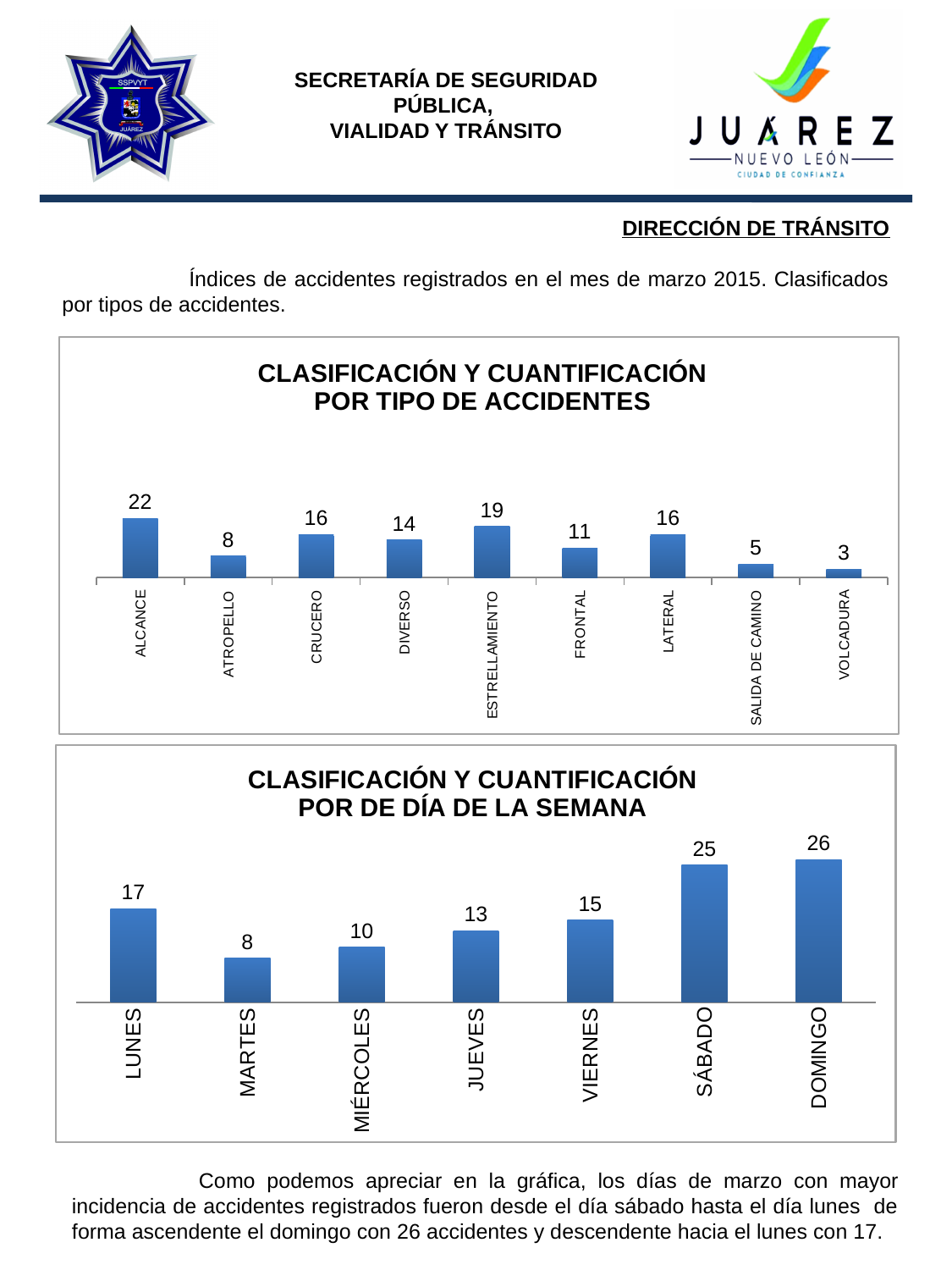
In the chart 'CLASIFICACIÓN Y CUANTIFICACIÓN POR DE DÍA DE LA SEMANA', what is the difference between DOMINGO and LUNES? 9 In the chart 'CLASIFICACIÓN Y CUANTIFICACIÓN POR DE DÍA DE LA SEMANA', which day has the lowest value? MARTES In the chart 'CLASIFICACIÓN Y CUANTIFICACIÓN POR TIPO DE ACCIDENTES', which category has the lowest value? VOLCADURA What kind of chart is 'CLASIFICACIÓN Y CUANTIFICACIÓN POR DE DÍA DE LA SEMANA'? bar chart In the chart 'CLASIFICACIÓN Y CUANTIFICACIÓN POR TIPO DE ACCIDENTES', how many categories are shown? 9 In the chart 'CLASIFICACIÓN Y CUANTIFICACIÓN POR TIPO DE ACCIDENTES', what is the value for ALCANCE? 22 In the chart 'CLASIFICACIÓN Y CUANTIFICACIÓN POR TIPO DE ACCIDENTES', what is the difference between ESTRELLAMIENTO and FRONTAL? 8 In the chart 'CLASIFICACIÓN Y CUANTIFICACIÓN POR DE DÍA DE LA SEMANA', which day has the highest value? DOMINGO In the chart 'CLASIFICACIÓN Y CUANTIFICACIÓN POR DE DÍA DE LA SEMANA', do the values rise or fall from MARTES to DOMINGO? rise In the chart 'CLASIFICACIÓN Y CUANTIFICACIÓN POR DE DÍA DE LA SEMANA', what is the value for SÁBADO? 25 In the chart 'CLASIFICACIÓN Y CUANTIFICACIÓN POR TIPO DE ACCIDENTES', which is larger, DIVERSO or SALIDA DE CAMINO? DIVERSO In the chart 'CLASIFICACIÓN Y CUANTIFICACIÓN POR TIPO DE ACCIDENTES', which category has the highest value? ALCANCE